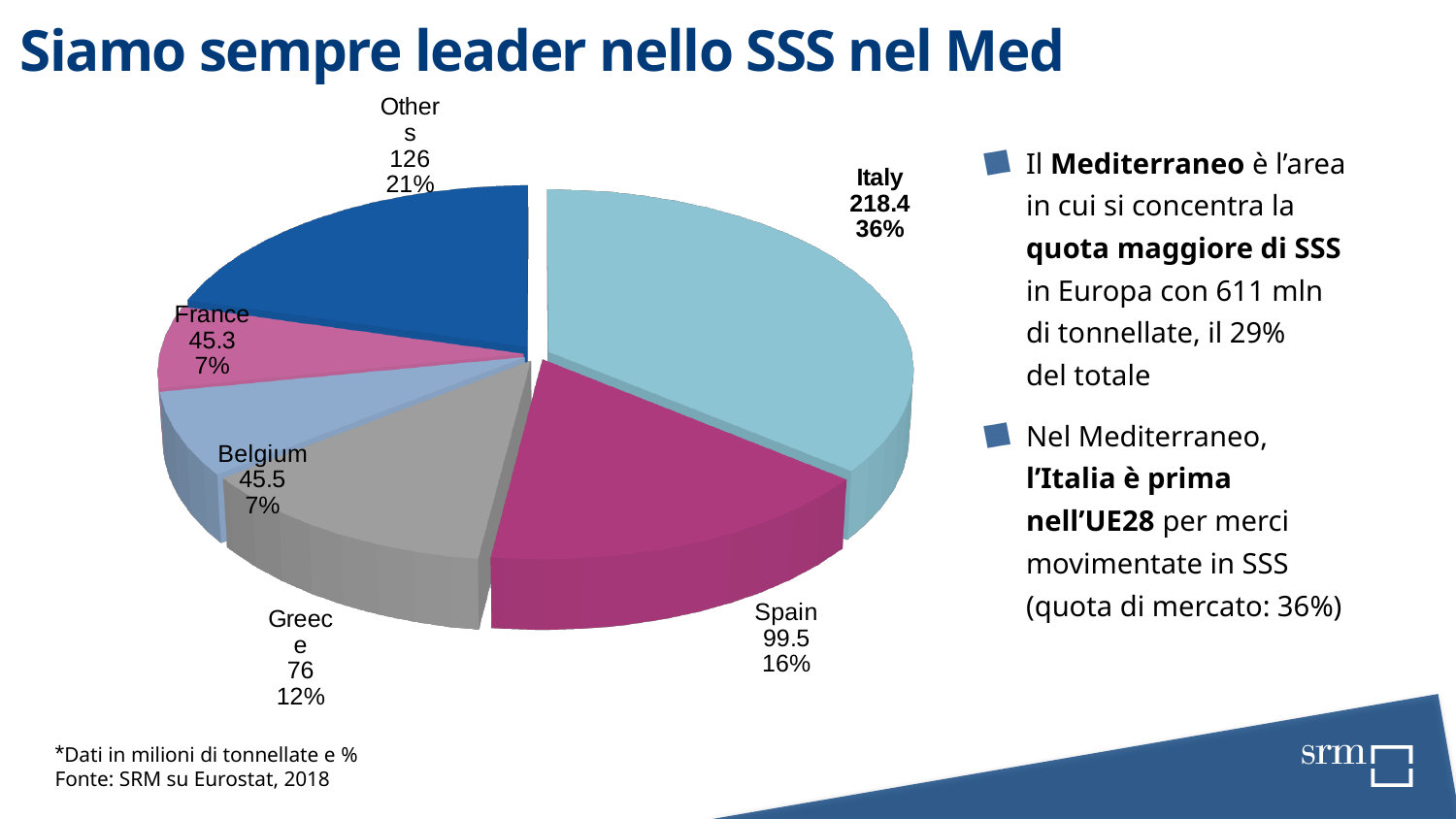
Which category has the largest slice in the pie chart? Italy What is the difference between the values for Italy and Spain? 118.9 What percentage share is shown for Belgium in the pie chart? 7% What value is shown for Italy in the pie chart? 218.4 What is the difference between the values for Belgium and France? 0.2 What kind of chart is shown on the slide? Pie chart What is the title of the slide containing the pie chart? Siamo sempre leader nello SSS nel Med What percentage share does Spain have in the pie chart? 16% How many slices does the pie chart have? 6 Which is larger, the value for Others or the value for Spain? Others What value is shown for Greece in the pie chart? 76 What percentage share is shown for Others in the pie chart? 21%